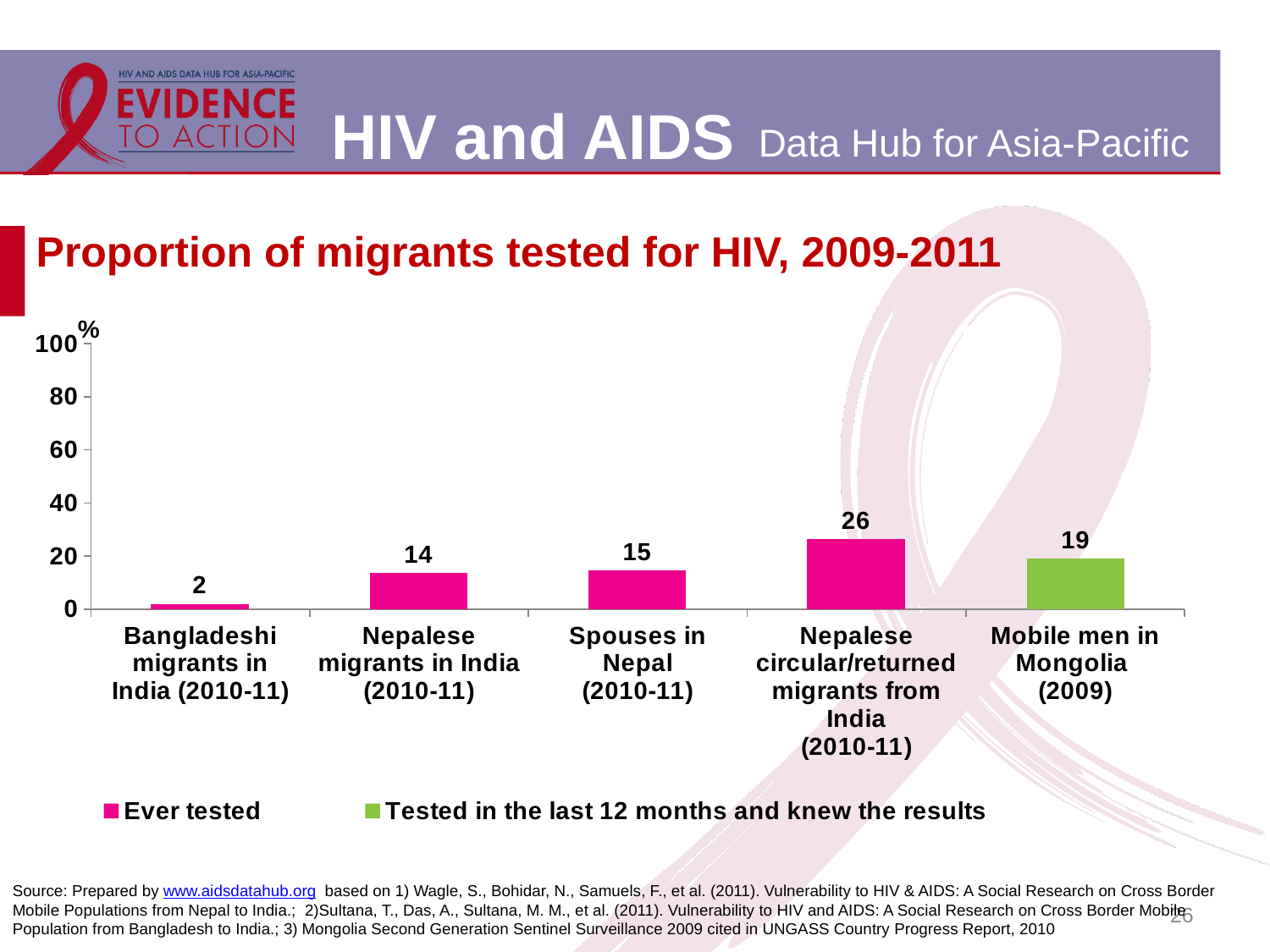
What kind of chart is shown on the slide? Bar chart What is the value for Bangladeshi migrants in India (2010-11)? 2 What is the difference between the values for Nepalese circular/returned migrants from India (2010-11) and Nepalese migrants in India (2010-11)? 12 What is the value for Nepalese circular/returned migrants from India (2010-11)? 26 Which category has the highest value? Nepalese circular/returned migrants from India (2010-11) Which is larger: the value for Mobile men in Mongolia (2009) or the value for Spouses in Nepal (2010-11)? Mobile men in Mongolia (2009) What is the value for Spouses in Nepal (2010-11)? 15 What is the value for Nepalese migrants in India (2010-11)? 14 What is the value for Mobile men in Mongolia (2009)? 19 How many categories are shown on the x axis? 5 How many series does the legend list? 2 Which category has the lowest value? Bangladeshi migrants in India (2010-11)